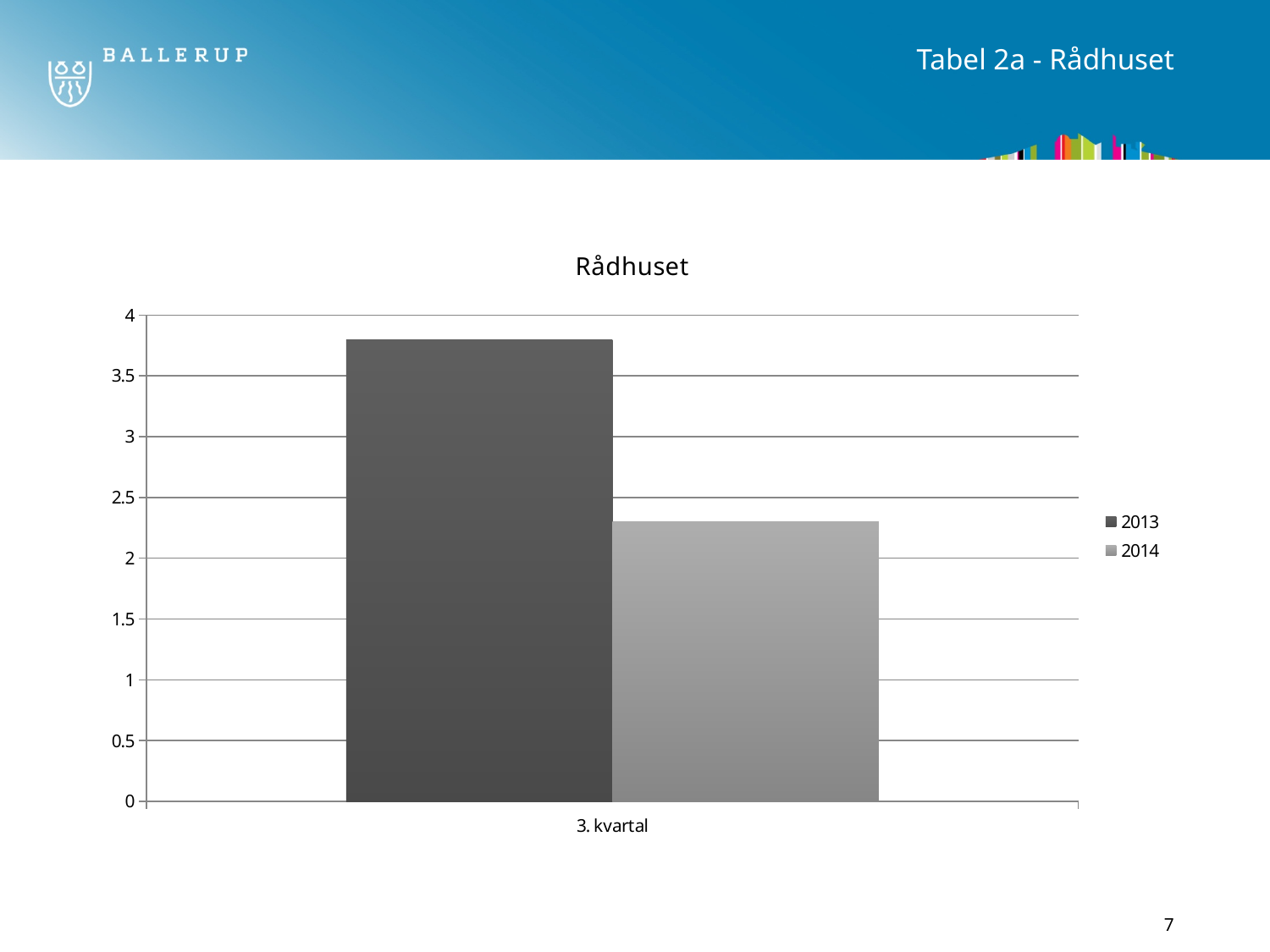
What is the title of the chart? Rådhuset Which series has the lowest bar in the chart? 2014 What kind of chart is shown on the slide? bar chart Which series are listed in the legend? 2013 and 2014 Is the value for 2014 in 3. kvartal greater or less than 2? greater How many series does the legend list? 2 Is the value for 2013 in 3. kvartal greater or less than 4? less Which series has the higher value for 3. kvartal, 2013 or 2014? 2013 Which series has the highest bar in the chart? 2013 Is the value for 2013 in 3. kvartal greater or less than 3.5? greater How many categories are shown on the x axis? 1